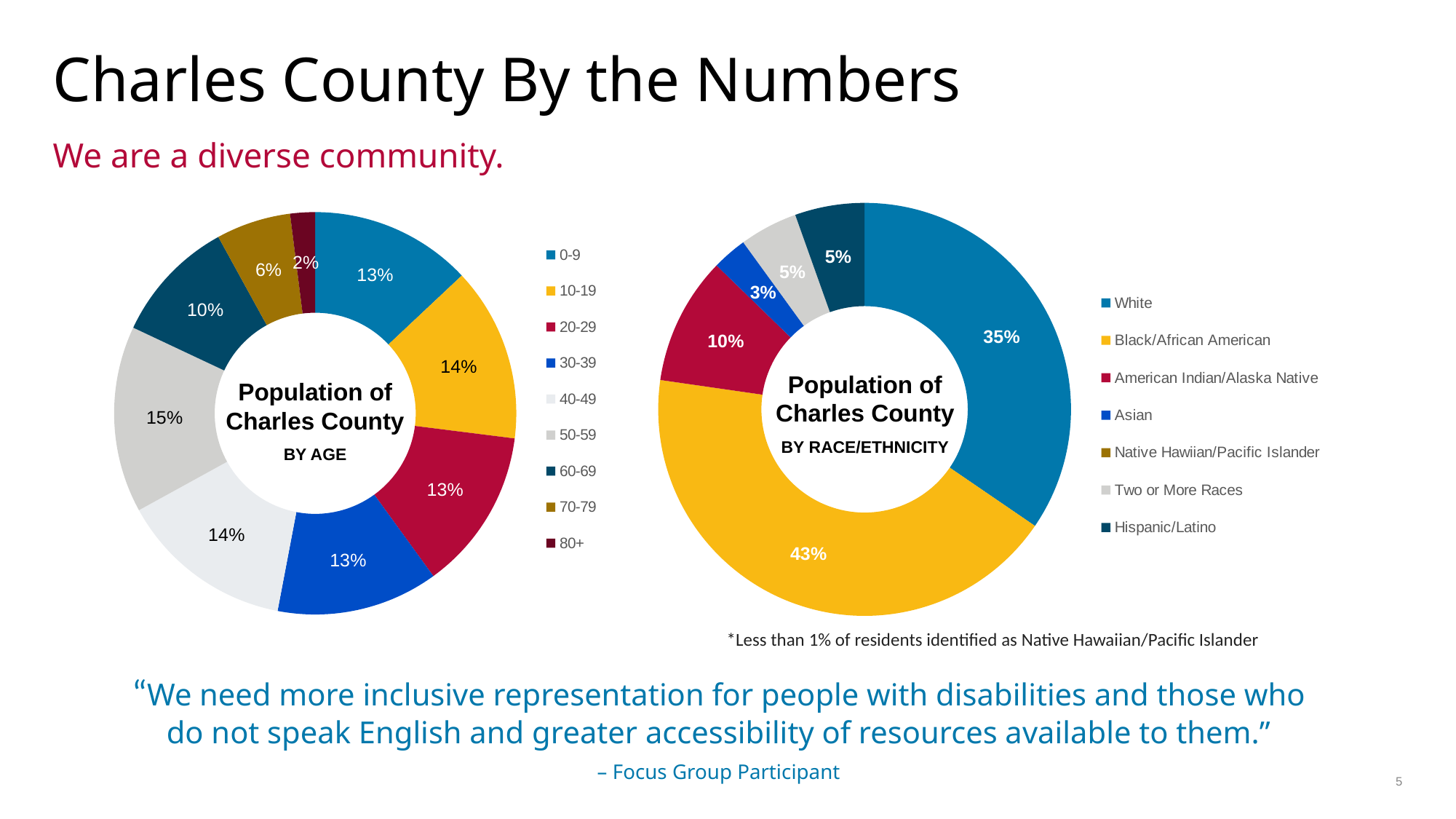
In the 'Population of Charles County by Race/Ethnicity' chart, which group has the largest share? Black/African American In the 'Population of Charles County by Age' chart, which age group has the smallest share? 80+ In the 'Population of Charles County by Age' chart, what is the difference between the shares for 60-69 and 70-79? 4% How many age groups does the legend of the 'Population of Charles County by Age' chart list? 9 In the 'Population of Charles County by Race/Ethnicity' chart, which is larger: the share for American Indian/Alaska Native or the share for Hispanic/Latino? American Indian/Alaska Native What kind of chart is the 'Population of Charles County by Race/Ethnicity' chart? Donut (pie) chart In the 'Population of Charles County by Race/Ethnicity' chart, what share of the population is Asian? 3% In the 'Population of Charles County by Race/Ethnicity' chart, what share of the population is Black/African American? 43% In the 'Population of Charles County by Age' chart, what share of the population is aged 50-59? 15% In the 'Population of Charles County by Age' chart, what share of the population is aged 80+? 2% In the 'Population of Charles County by Age' chart, which age group has the largest share? 50-59 In the 'Population of Charles County by Race/Ethnicity' chart, what is the difference between the shares for Black/African American and White? 8%